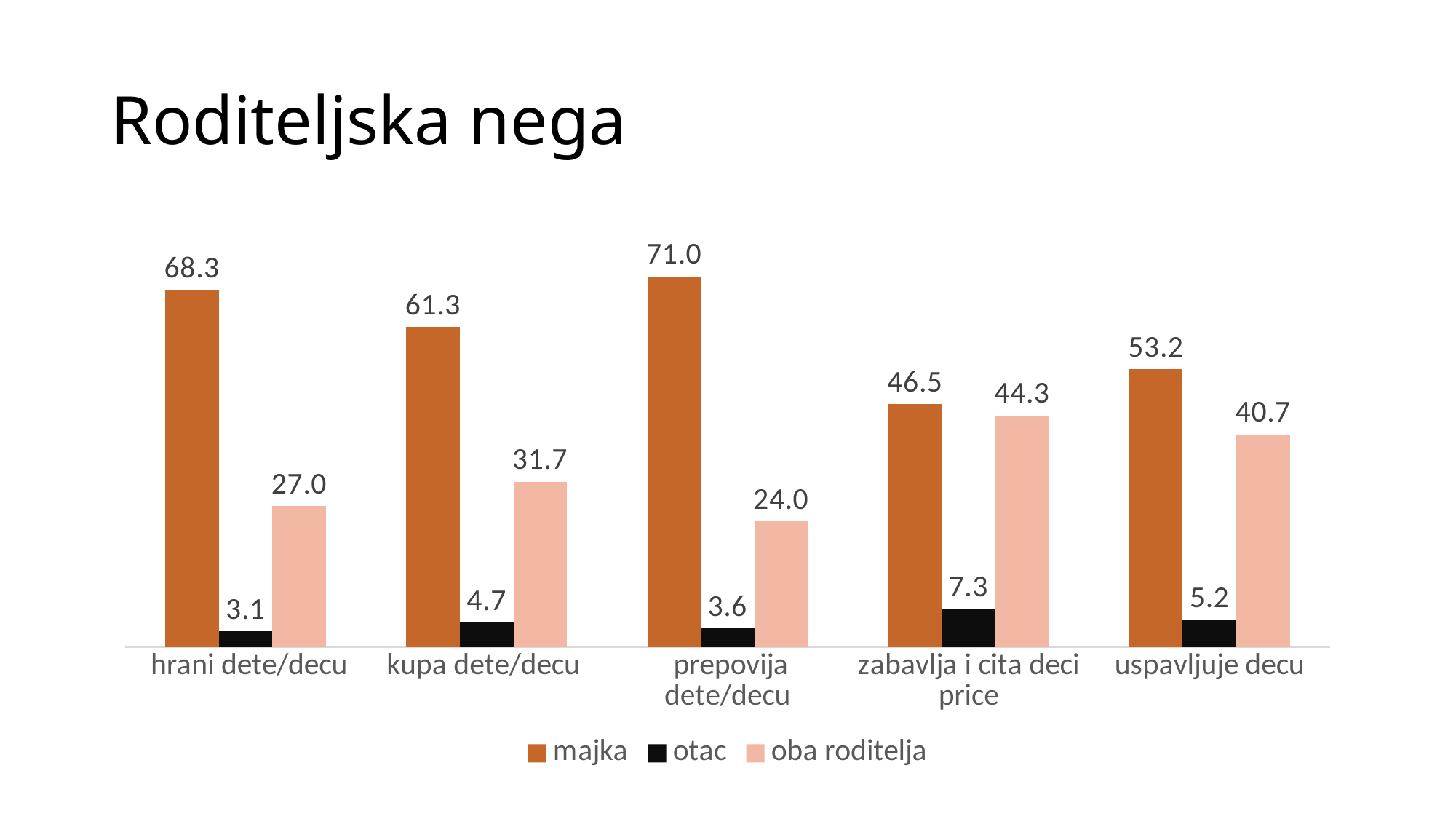
How many categories are shown on the x axis? 5 What is the title of the slide? Roditeljska nega What is the difference between the majka and oba roditelja values in the uspavljuje decu category? 12.5 How many series does the legend list? 3 In the zabavlja i cita deci price category, which is larger: majka or oba roditelja? majka What is the value for otac in the zabavlja i cita deci price category? 7.3 What is the value for majka in the hrani dete/decu category? 68.3 What is the value for oba roditelja in the kupa dete/decu category? 31.7 Which category has the lowest value for otac? hrani dete/decu Which category has the highest value for majka? prepovija dete/decu What kind of chart is shown on the slide? bar chart Which category has the highest value for oba roditelja? zabavlja i cita deci price